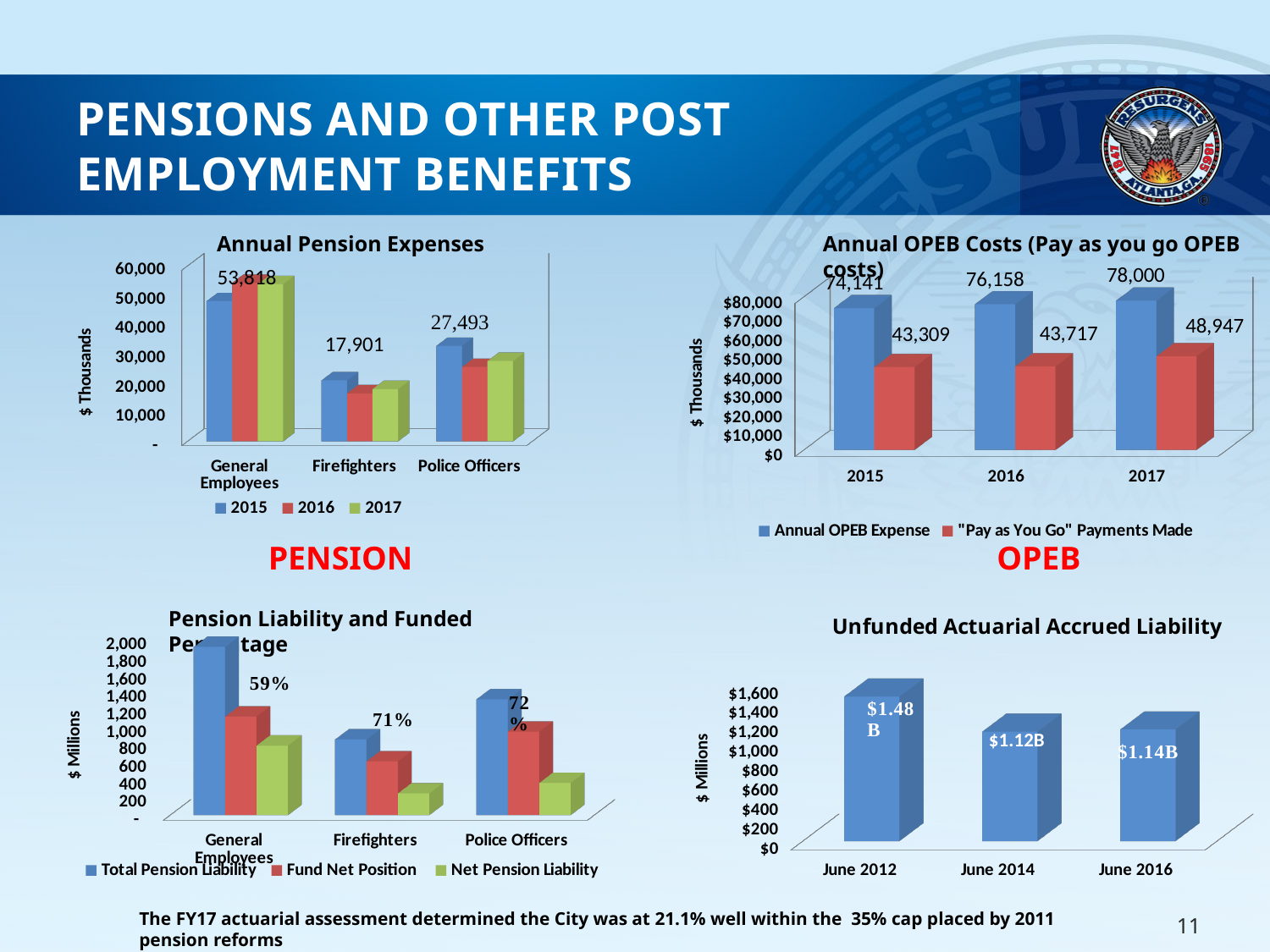
In the 'Unfunded Actuarial Accrued Liability' chart, what is the value for June 2012? $1.48B In the 'Annual OPEB Costs' chart, what is the 'Pay as You Go' Payments Made value for 2015? 43,309 In the 'Pension Liability and Funded Percentage' chart, what funded percentage is shown for Police Officers? 72% In the 'Annual OPEB Costs' chart, what is the Annual OPEB Expense for 2017? 78,000 In the 'Unfunded Actuarial Accrued Liability' chart, which period has the lowest value? June 2014 In the 'Annual OPEB Costs' chart, what is the difference between the Annual OPEB Expense and the 'Pay as You Go' Payments Made in 2016? 32,441 In the 'Annual Pension Expenses' chart, what data label is shown for Firefighters? 17,901 In the 'Annual OPEB Costs' chart, does the Annual OPEB Expense rise or fall from 2015 to 2017? rise How many series does the legend of the 'Annual OPEB Costs' chart list? 2 In the 'Annual Pension Expenses' chart, which category has the highest pension expenses? General Employees How many bars are shown in the 'Unfunded Actuarial Accrued Liability' chart? 3 In the 'Pension Liability and Funded Percentage' chart, is the Total Pension Liability for General Employees greater or less than 1,600? greater